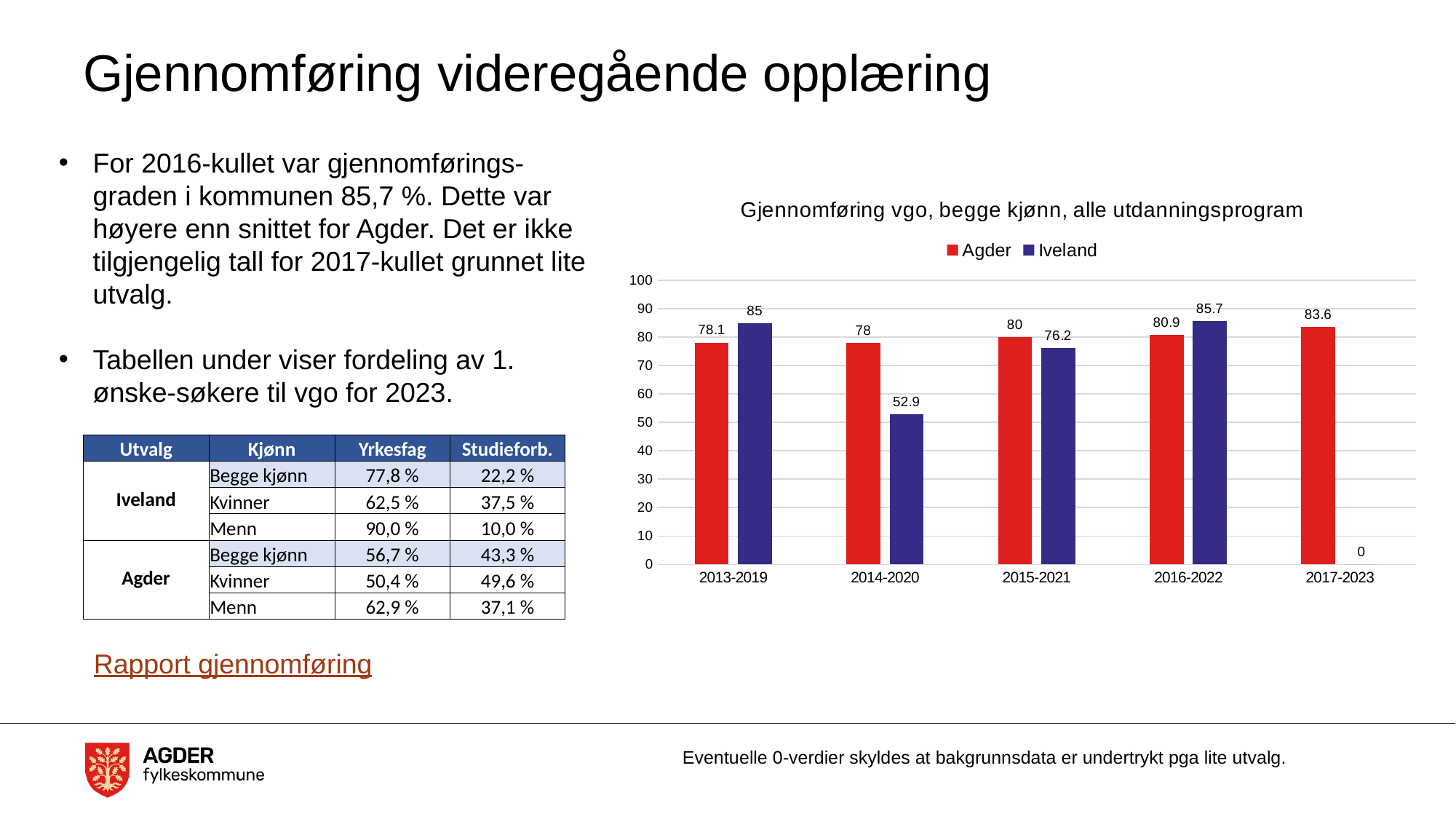
How many series does the legend list? 2 What is the value for Agder in 2013-2019? 78.1 Which period has the highest value for Agder? 2017-2023 Which period has the lowest value for Iveland? 2017-2023 What is the value for Iveland in 2014-2020? 52.9 How many periods are shown on the x axis? 5 What is the value for Iveland in 2016-2022? 85.7 What kind of chart is shown? Bar chart What is the title of the chart? Gjennomføring vgo, begge kjønn, alle utdanningsprogram Which is larger in 2015-2021, Agder or Iveland? Agder What is the difference between Agder and Iveland in 2014-2020? 25.1 What is the value for Agder in 2017-2023? 83.6